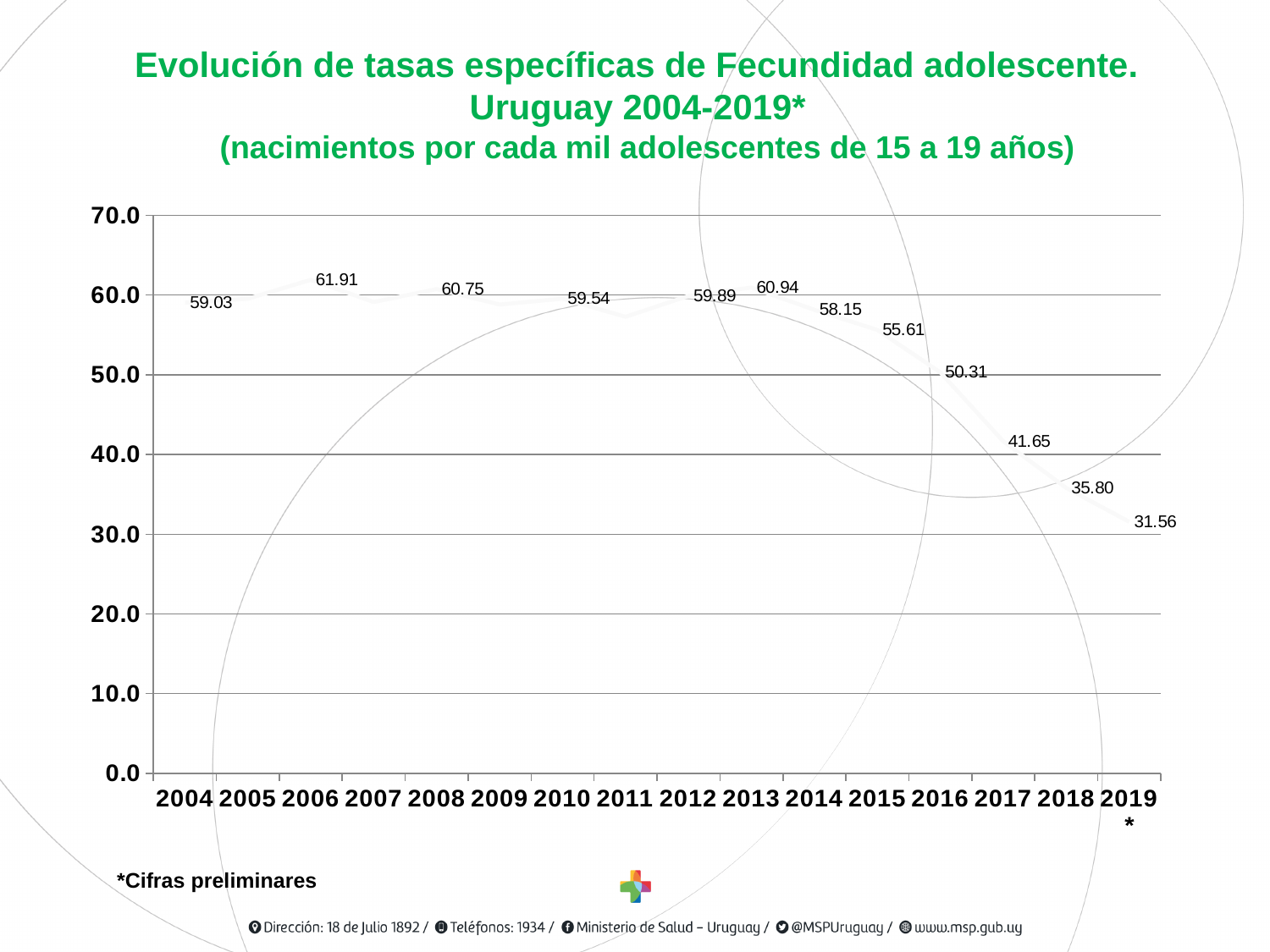
Which year has the lowest value? 2019 What kind of chart is this? line chart Which is larger, the value for 2013 or the value for 2014? 2013 What is the value for 2019? 31.56 Which year has the highest value? 2006 Is the value for 2011 greater or less than 60.0? less What is the value for 2004? 59.03 What is the difference between the values for 2016 and 2017? 8.66 What is the difference between the values for 2004 and 2019? 27.47 Do the values rise or fall from 2013 to 2019? fall How many years are shown on the x axis? 16 What is the value for 2016? 50.31